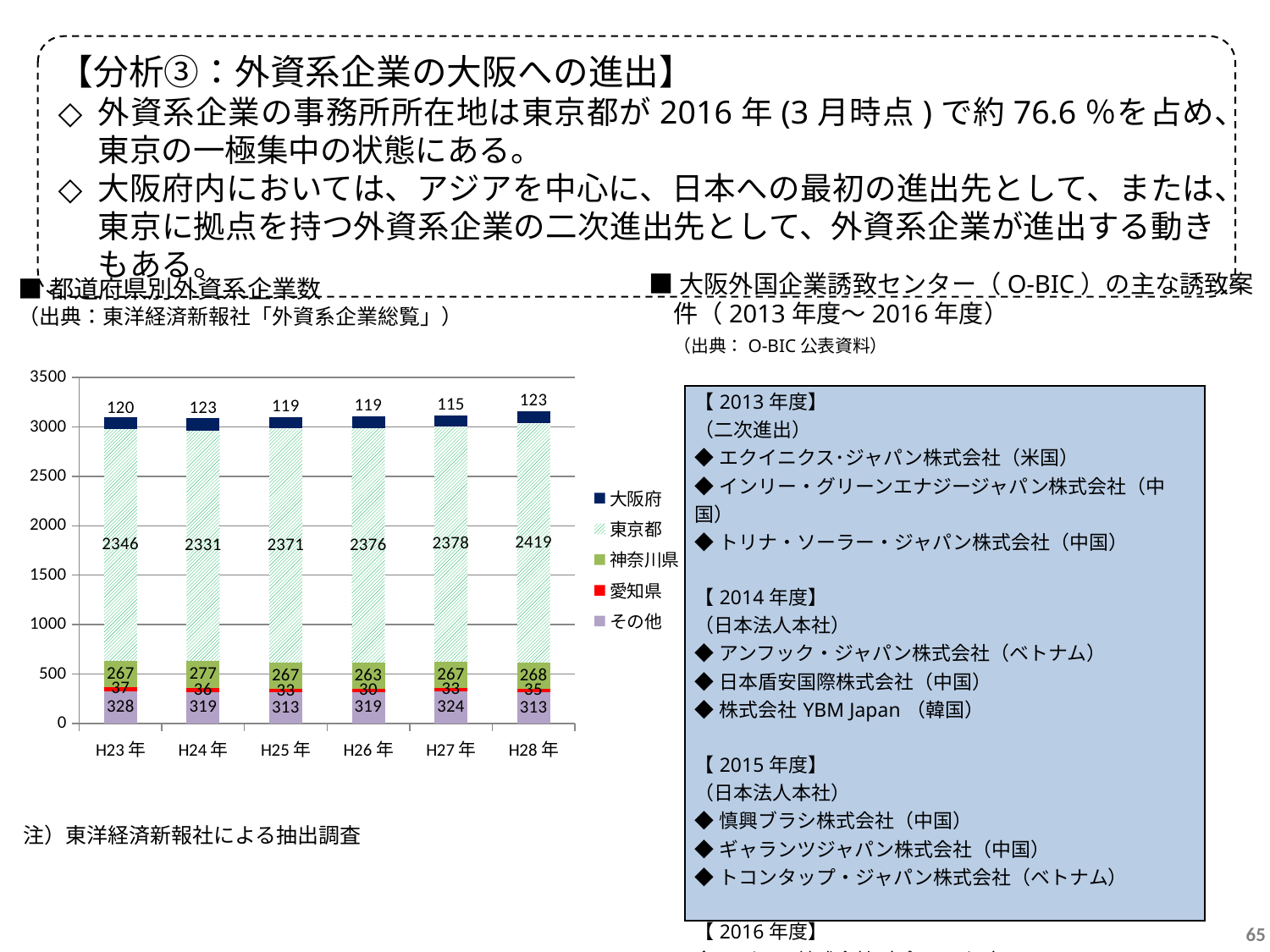
What type of chart is used to show the number of foreign-affiliated companies by prefecture (都道府県別外資系企業数)? stacked bar chart In the 都道府県別外資系企業数 chart, which year has the highest value for 東京都? H28年 How many years (categories) are shown on the x axis of the 都道府県別外資系企業数 chart? 6 How many series does the legend of the 都道府県別外資系企業数 chart list? 5 In the 都道府県別外資系企業数 chart, what is the total of the stacked bar for H23年? 3098 In the 都道府県別外資系企業数 chart, is the value for その他 larger in H23年 or in H28年? H23年 In the 都道府県別外資系企業数 chart, which year has the lowest value for 大阪府? H27年 In the 都道府県別外資系企業数 chart, what is the value for 神奈川県 in H24年? 277 In the 都道府県別外資系企業数 chart, what is the value for 大阪府 in H27年? 115 In the 都道府県別外資系企業数 chart, what is the value for 東京都 in H28年? 2419 In the 都道府県別外資系企業数 chart, what is the difference between the 東京都 values for H28年 and H23年? 73 In the 都道府県別外資系企業数 chart, does the value for 東京都 rise or fall from H24年 to H28年? rise